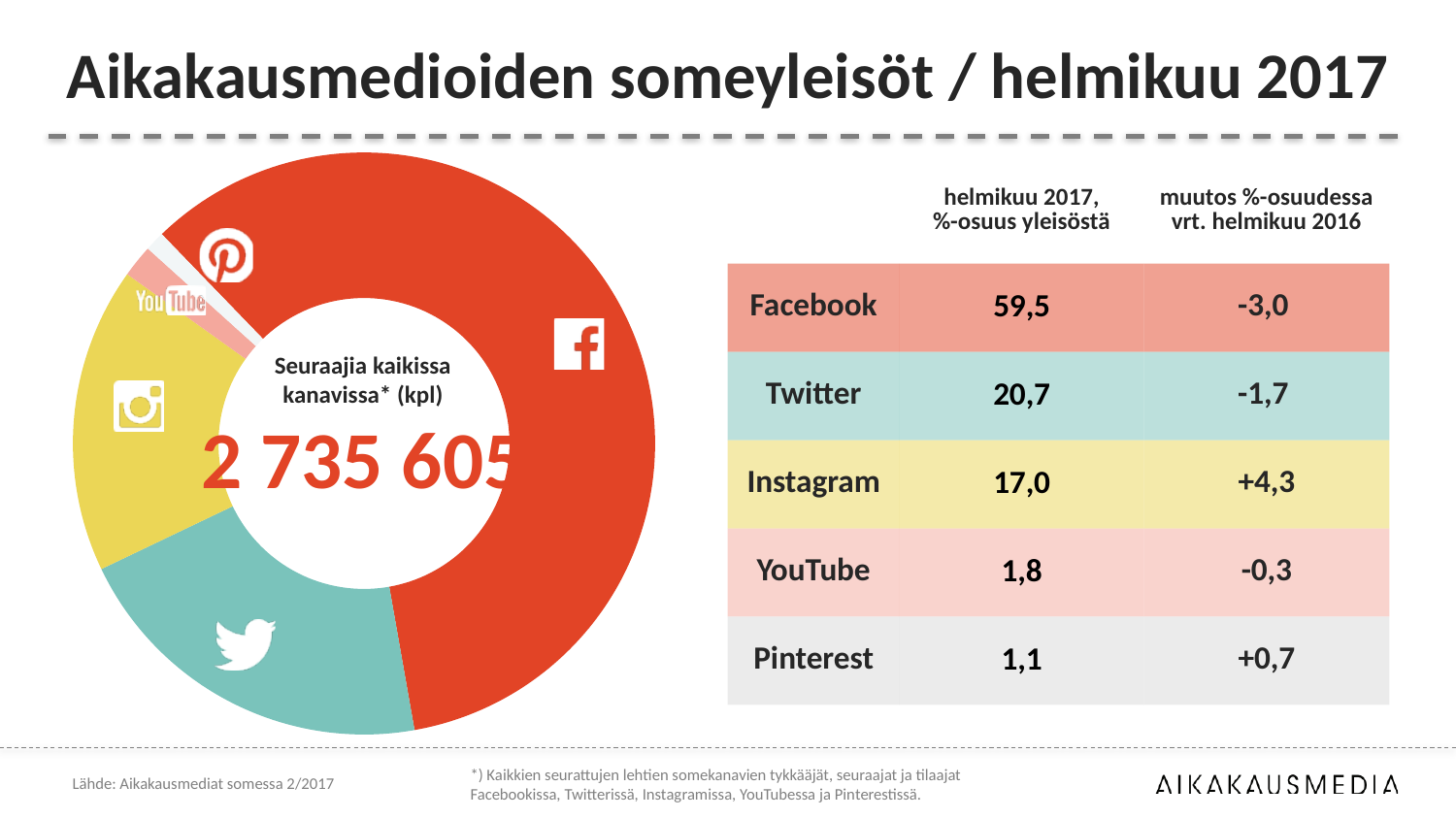
Which has a larger share of the audience, Twitter or Instagram? Twitter What is the total number of followers across all channels shown in the centre of the pie chart? 2 735 605 What is the change in Facebook's share compared with February 2016? -3,0 What is the change in Instagram's share compared with February 2016? +4,3 Which channel has the smallest share of the audience in the pie chart? Pinterest What is the difference in percentage share between Facebook (59,5) and Twitter (20,7)? 38,8 What is Facebook's share of the audience in February 2017 according to the table? 59,5 What is the title of the slide? Aikakausmedioiden someyleisöt / helmikuu 2017 How many social media channels are shown as slices in the pie chart? 5 Which channel has the largest share of the audience in the pie chart? Facebook What kind of chart is shown on the left of the slide? pie chart (donut) What is Instagram's share of the audience in February 2017 according to the table? 17,0